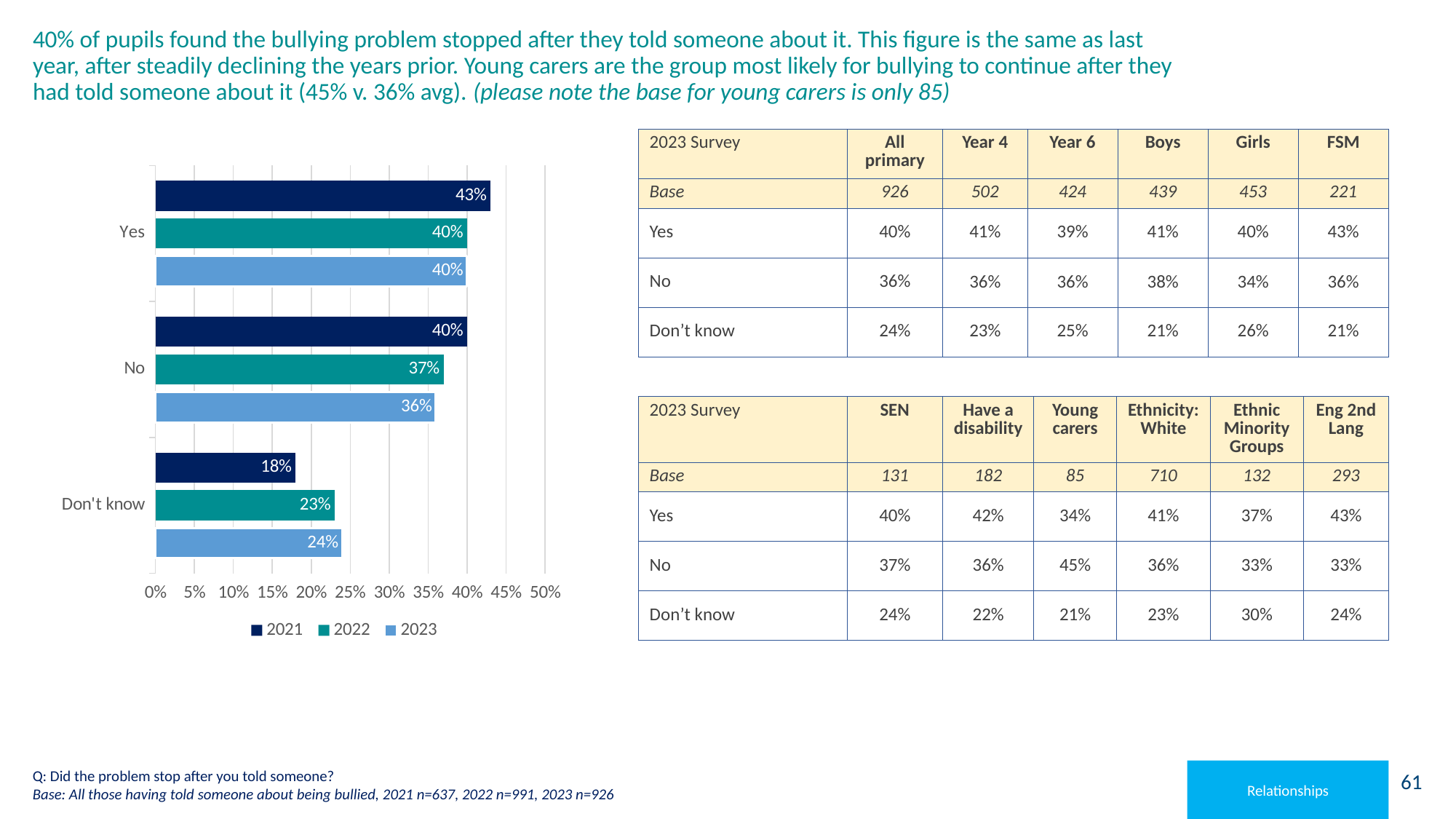
How many categories are shown on the chart? 3 Which year has the lowest value for "Don't know"? 2021 How many series does the legend list? 3 Which year has the highest value for "Yes"? 2021 What is the value for "Don't know" in 2022? 23% What is the difference between the 2021 and 2023 values for "No"? 4% What kind of chart is shown on the slide? bar chart What is the value for "Yes" in 2021? 43% Which is larger: the 2022 value for "No" or the 2023 value for "No"? 2022 What is the value for "Don't know" in 2021? 18% What is the value for "No" in 2023? 36% Do the values for "Don't know" rise or fall from 2021 to 2023? rise